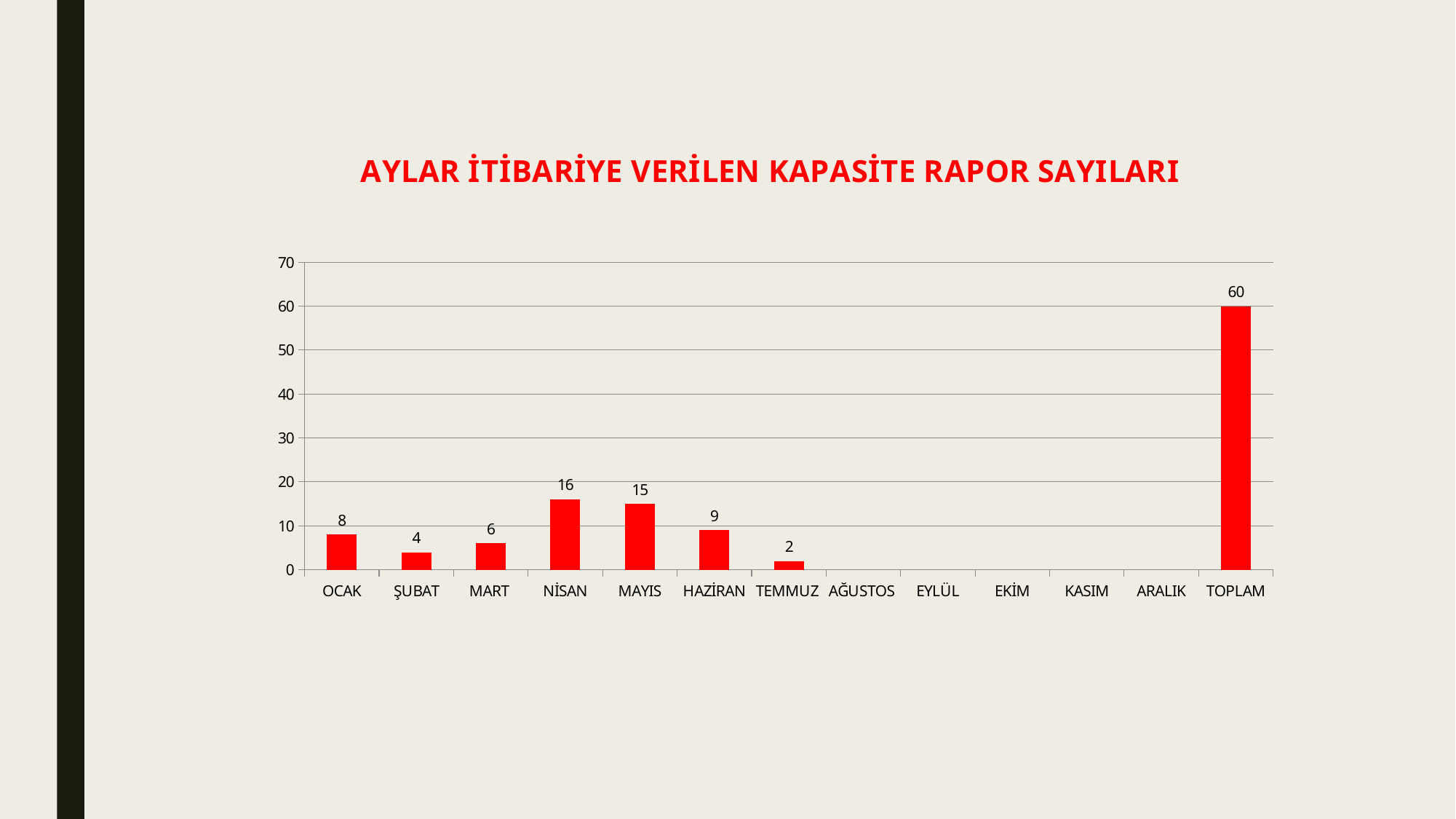
What is the difference between the values for NİSAN and MAYIS? 1 What is the value for TEMMUZ? 2 Which is larger, the value for HAZİRAN or the value for MART? HAZİRAN Which month (excluding TOPLAM) has the highest value? NİSAN Among the months with a visible bar, which has the lowest value? TEMMUZ What is the title of the chart? AYLAR İTİBARİYE VERİLEN KAPASİTE RAPOR SAYILARI What is the value for NİSAN? 16 Is the value for TOPLAM greater or less than 50? greater What is the value for TOPLAM? 60 What is the difference between the values for OCAK and ŞUBAT? 4 What kind of chart is shown on the slide? bar chart How many categories are shown on the x axis? 13